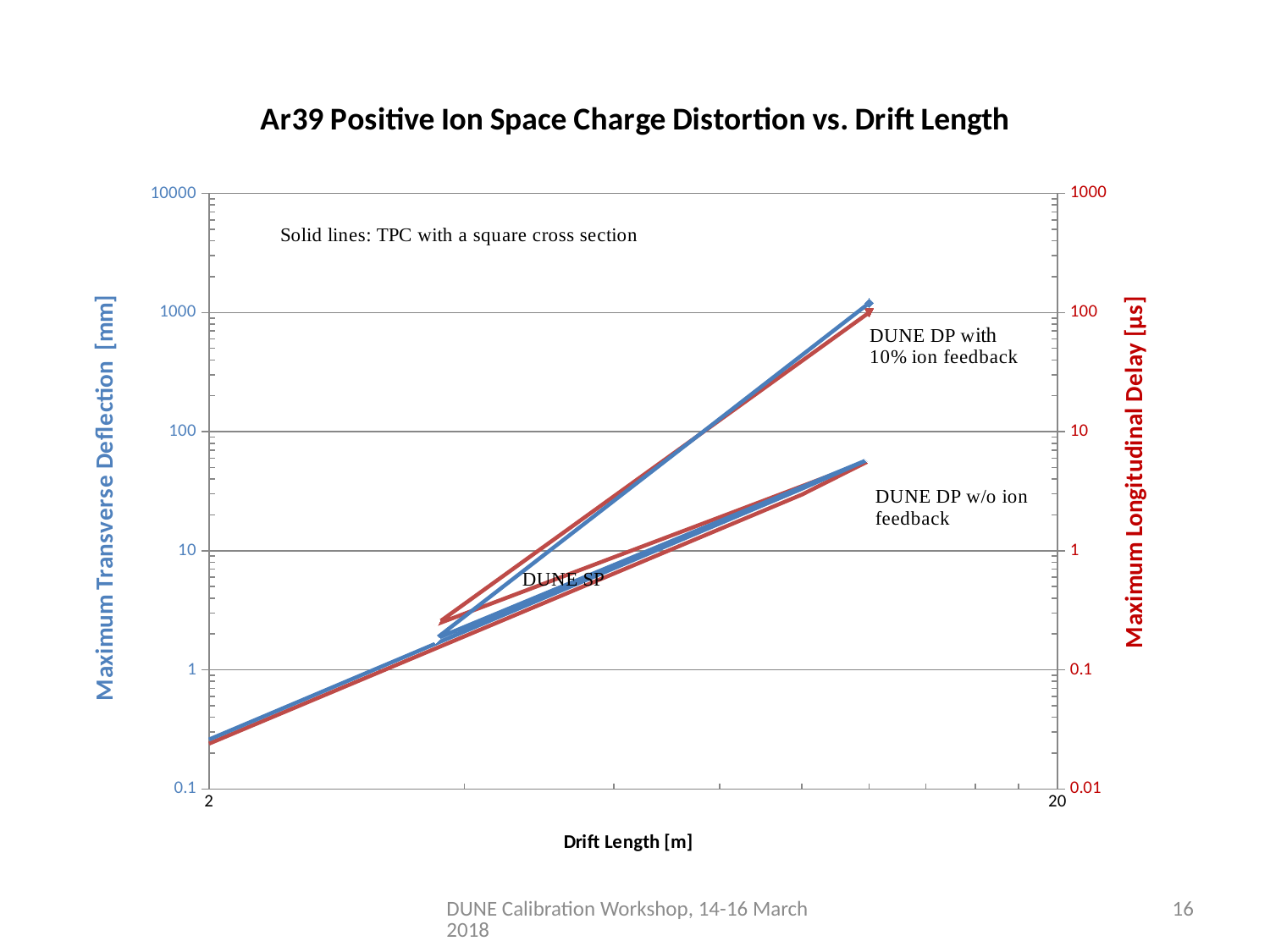
Which reaches a larger maximum transverse deflection at its endpoint: DUNE DP with 10% ion feedback or DUNE DP w/o ion feedback? DUNE DP with 10% ion feedback What is the lowest value shown on the left y axis of the chart? 0.1 What is the title of the chart? Ar39 Positive Ion Space Charge Distortion vs. Drift Length Is the maximum transverse deflection at the end of the DUNE DP with 10% ion feedback curve greater or less than 100 mm? greater Is the maximum transverse deflection at a drift length of 2 m greater or less than 1 mm? less Do the plotted values rise or fall as drift length increases? rise Is the maximum transverse deflection at the end of the DUNE DP w/o ion feedback curve greater or less than 10 mm? greater What kind of chart is shown on the slide? line chart How many labelled detector configurations are plotted on the chart? 3 Which labelled configuration reaches the highest maximum transverse deflection? DUNE DP with 10% ion feedback What quantity is plotted on the x axis of the chart? Drift Length [m]